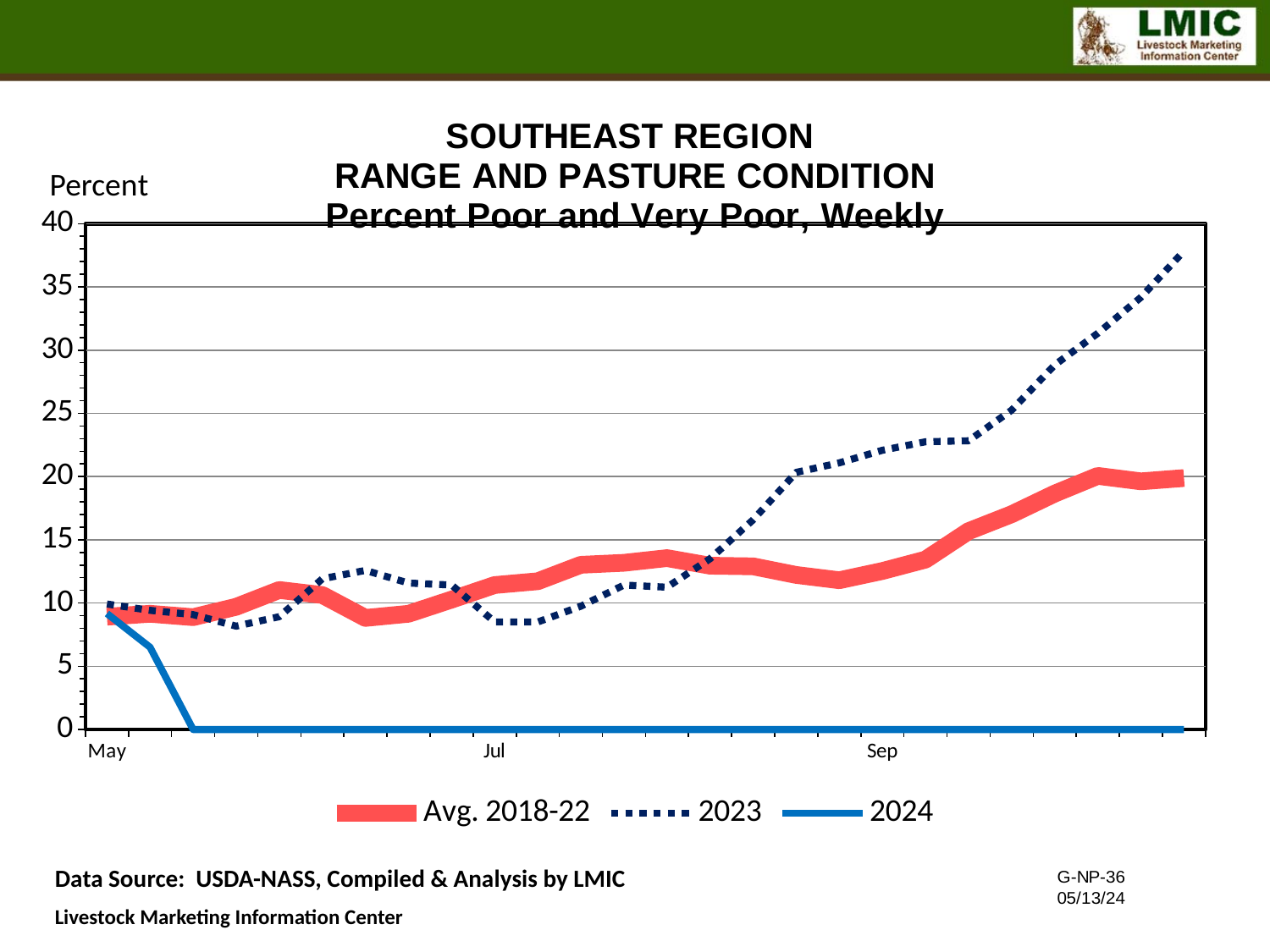
Which series has the higher value at the right end of the chart, 2023 or Avg. 2018-22? 2023 What kind of chart is shown on the slide? line chart Is the value of the 2023 series at the Sep tick greater or less than 15? greater Which series has the lowest value at the right end of the chart? 2024 How many month labels appear on the x axis? 3 How many series does the legend list? 3 Is the value of the 2023 series at the right end of the chart greater or less than 35? greater Is the value of the Avg. 2018-22 series at the right end of the chart greater or less than 15? greater What is the label on the vertical axis? Percent Does the 2023 series overall rise or fall from May to the end of the chart? rise Which series is drawn as a dotted line? 2023 Which series has the higher value at the Jul tick, 2023 or Avg. 2018-22? Avg. 2018-22